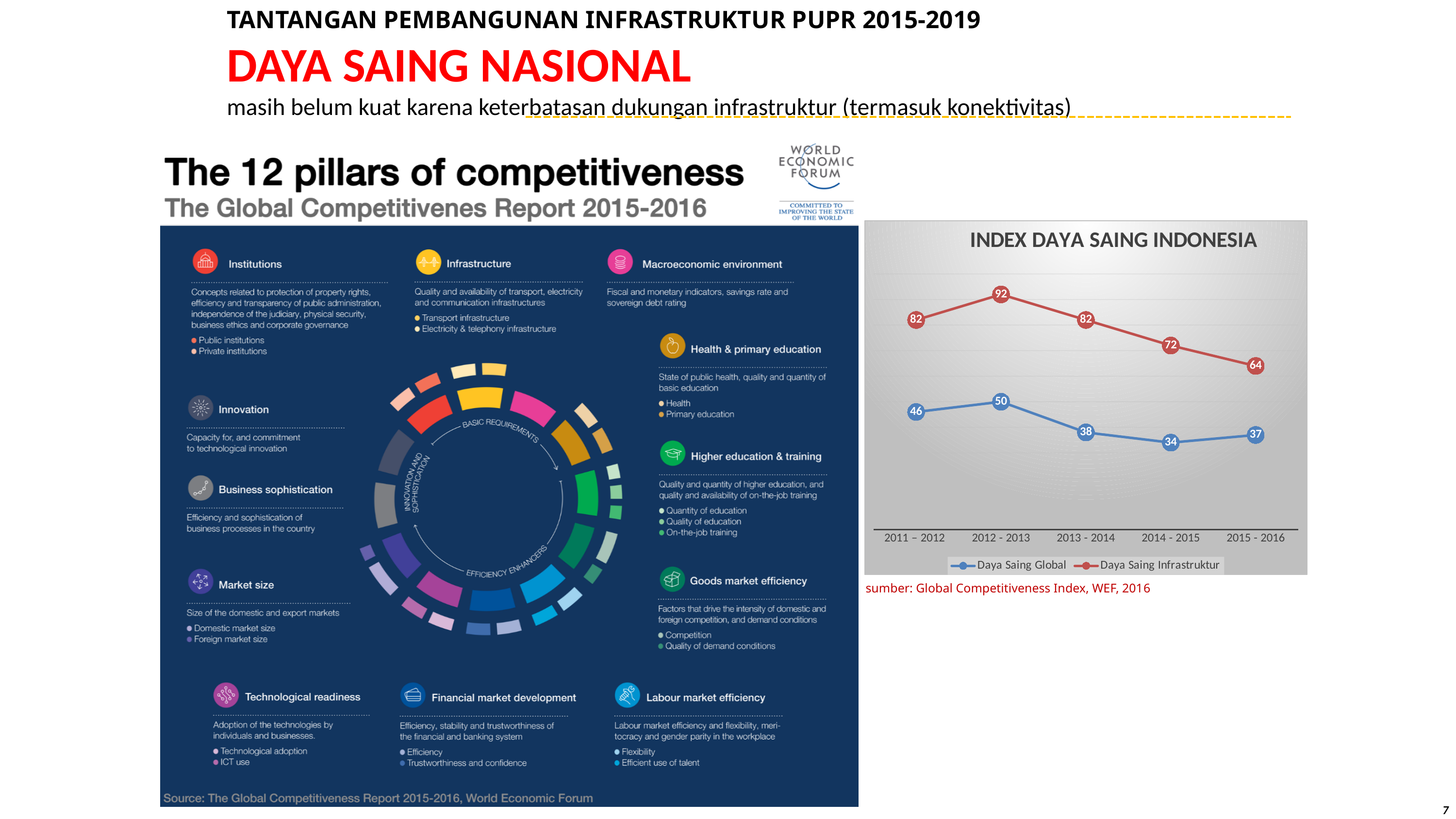
In the INDEX DAYA SAING INDONESIA chart, does Daya Saing Infrastruktur rise or fall from 2012 - 2013 to 2015 - 2016? Fall In the INDEX DAYA SAING INDONESIA chart, what is the value of Daya Saing Infrastruktur for 2012 - 2013? 92 In the INDEX DAYA SAING INDONESIA chart, what is the value of Daya Saing Infrastruktur for 2015 - 2016? 64 What kind of chart is INDEX DAYA SAING INDONESIA? Line chart In the INDEX DAYA SAING INDONESIA chart, which period has the highest Daya Saing Infrastruktur value? 2012 - 2013 In the INDEX DAYA SAING INDONESIA chart, what is the value of Daya Saing Global for 2014 - 2015? 34 In the INDEX DAYA SAING INDONESIA chart, which period has the lowest Daya Saing Global value? 2014 - 2015 How many periods are shown on the x axis of the INDEX DAYA SAING INDONESIA chart? 5 In the INDEX DAYA SAING INDONESIA chart, which is larger in 2013 - 2014: Daya Saing Global or Daya Saing Infrastruktur? Daya Saing Infrastruktur How many series does the legend of the INDEX DAYA SAING INDONESIA chart list? 2 In the INDEX DAYA SAING INDONESIA chart, what is the difference between Daya Saing Infrastruktur and Daya Saing Global in 2011 – 2012? 36 In the INDEX DAYA SAING INDONESIA chart, by how much did Daya Saing Infrastruktur fall from 2012 - 2013 to 2015 - 2016? 28